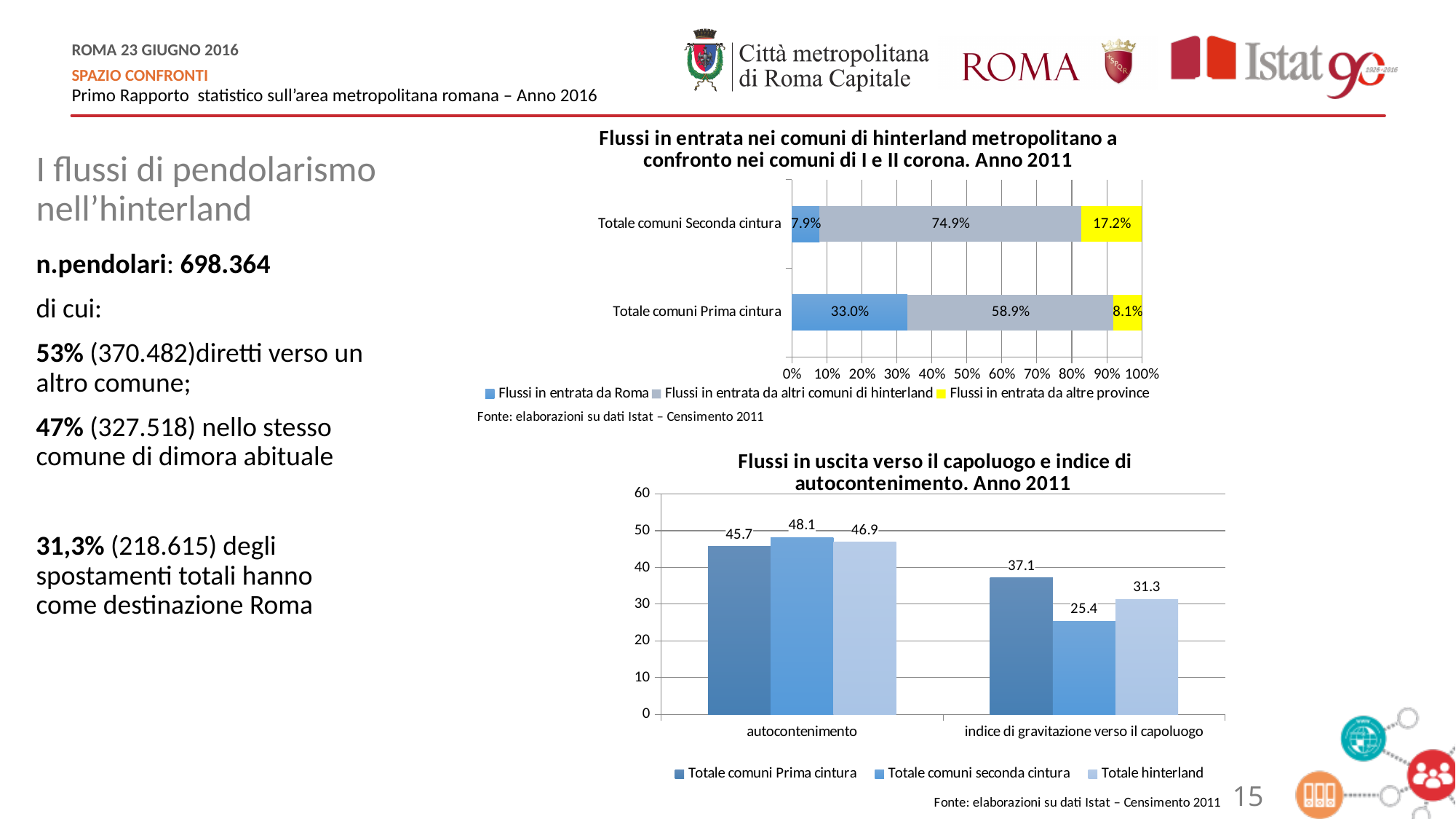
How many categories are shown on the x axis of the bottom chart (Flussi in uscita verso il capoluogo e indice di autocontenimento)? 2 In the top chart (Flussi in entrata nei comuni di hinterland metropolitano), which category has the larger share of Flussi in entrata da Roma, Totale comuni Prima cintura or Totale comuni Seconda cintura? Totale comuni Prima cintura In the bottom chart (Flussi in uscita verso il capoluogo e indice di autocontenimento), what is the difference between Totale comuni Prima cintura and Totale comuni seconda cintura for indice di gravitazione verso il capoluogo? 11.7 In the top chart (Flussi in entrata nei comuni di hinterland metropolitano), what is the value of Flussi in entrata da Roma for Totale comuni Prima cintura? 33.0% In the top chart (Flussi in entrata nei comuni di hinterland metropolitano), what is the value of Flussi in entrata da altri comuni di hinterland for Totale comuni Seconda cintura? 74.9% How many series does the legend of the top chart (Flussi in entrata nei comuni di hinterland metropolitano) list? 3 In the bottom chart (Flussi in uscita verso il capoluogo e indice di autocontenimento), what is the value of Totale hinterland for autocontenimento? 46.9 In the bottom chart (Flussi in uscita verso il capoluogo e indice di autocontenimento), what is the value of Totale comuni seconda cintura for indice di gravitazione verso il capoluogo? 25.4 In the top chart (Flussi in entrata nei comuni di hinterland metropolitano), what is the difference between the Flussi in entrata da altre province shares of Totale comuni Seconda cintura and Totale comuni Prima cintura? 9.1% In the top chart (Flussi in entrata nei comuni di hinterland metropolitano), what is the value of Flussi in entrata da altre province for Totale comuni Seconda cintura? 17.2% In the bottom chart (Flussi in uscita verso il capoluogo e indice di autocontenimento), which series has the highest value for autocontenimento? Totale comuni seconda cintura What type of chart is the top chart (Flussi in entrata nei comuni di hinterland metropolitano)? Stacked bar chart